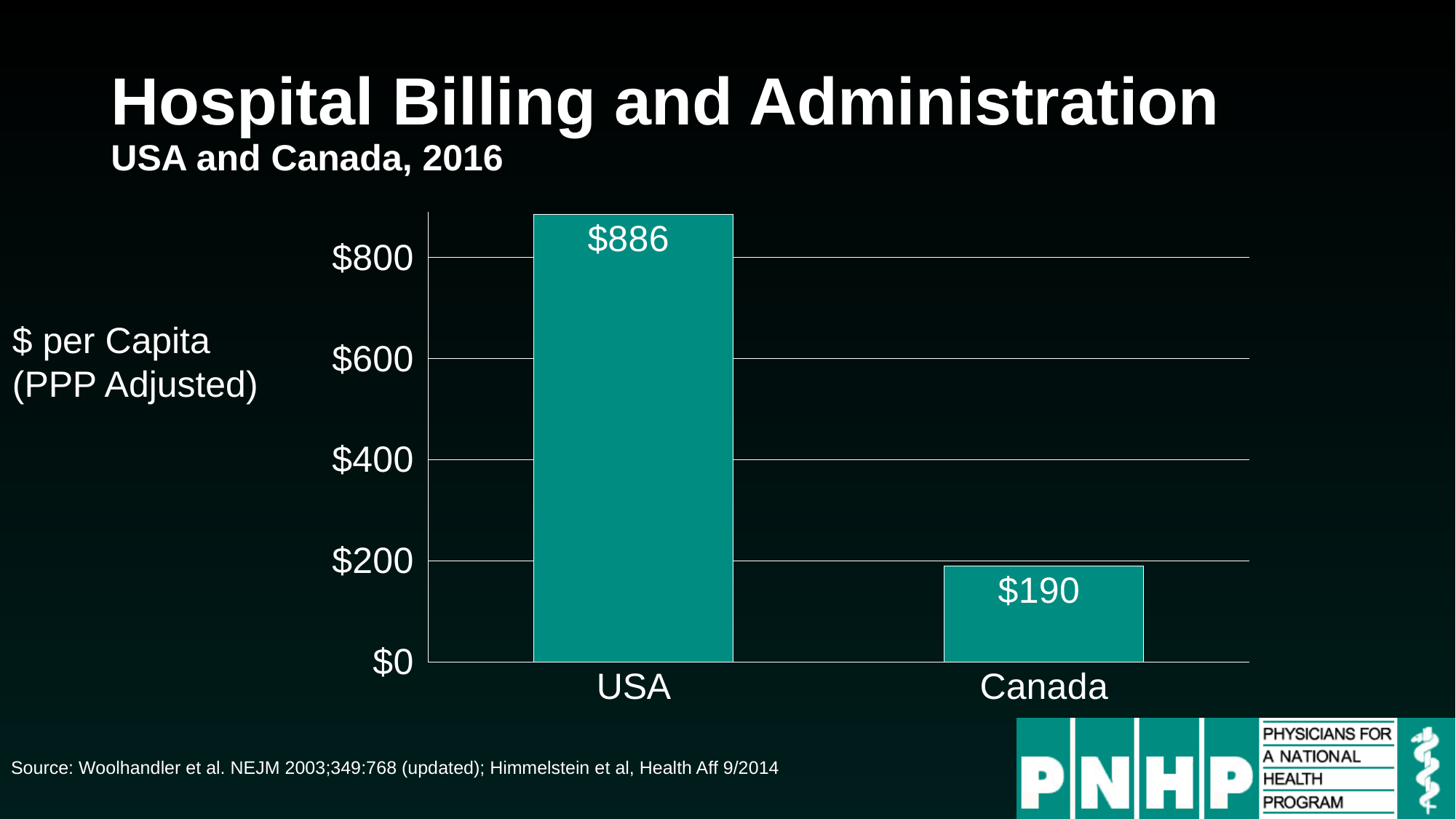
What is the difference between the USA and Canada values? $696 What kind of chart is shown on the slide? bar chart How many countries are shown in the chart? 2 What unit is the y axis labelled with? $ per Capita (PPP Adjusted) What is the hospital billing and administration cost per capita for the USA? $886 What is the hospital billing and administration cost per capita for Canada? $190 Which country has the lower hospital billing and administration cost per capita? Canada Is the value for the USA larger or smaller than the value for Canada? larger Which country has the higher hospital billing and administration cost per capita? USA What is the title of the chart on the slide? Hospital Billing and Administration Is the value for the USA greater or less than $800? greater Is the value for Canada greater or less than $200? less